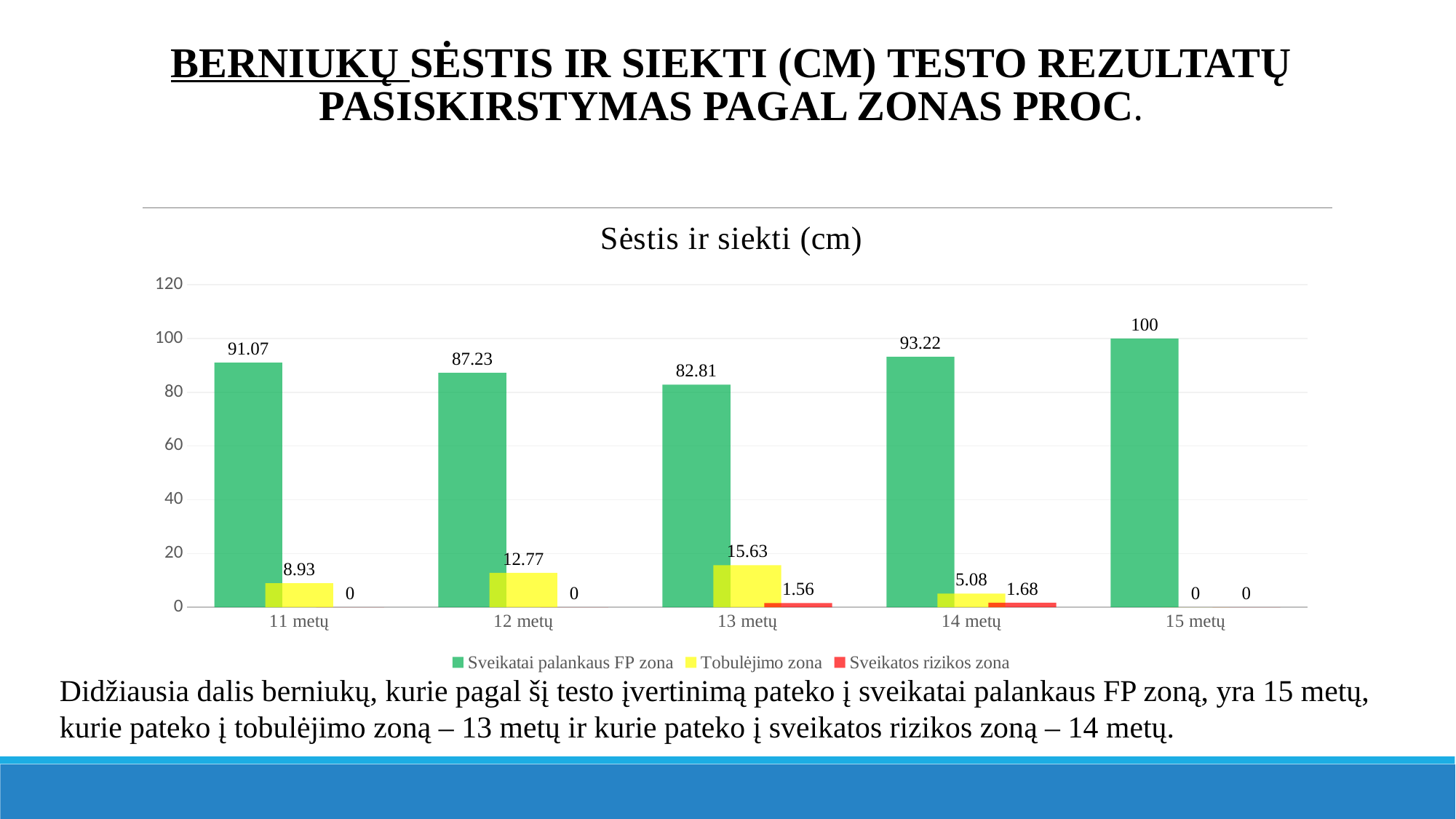
What kind of chart is shown on the slide? Bar chart Which is larger: the Tobulėjimo zona value at 12 metų or at 14 metų? 12 metų Which age group has the highest value for Sveikatai palankaus FP zona? 15 metų What is the value for Tobulėjimo zona at 13 metų? 15.63 Which age group has the lowest value for Sveikatai palankaus FP zona? 13 metų What is the title of the chart? Sėstis ir siekti (cm) What is the value for Sveikatai palankaus FP zona at 11 metų? 91.07 Which age group has the highest value for Tobulėjimo zona? 13 metų How many series does the legend list? 3 What is the difference between the Sveikatai palankaus FP zona values for 14 metų and 12 metų? 5.99 How many age groups are shown on the x axis? 5 What is the value for Sveikatos rizikos zona at 14 metų? 1.68